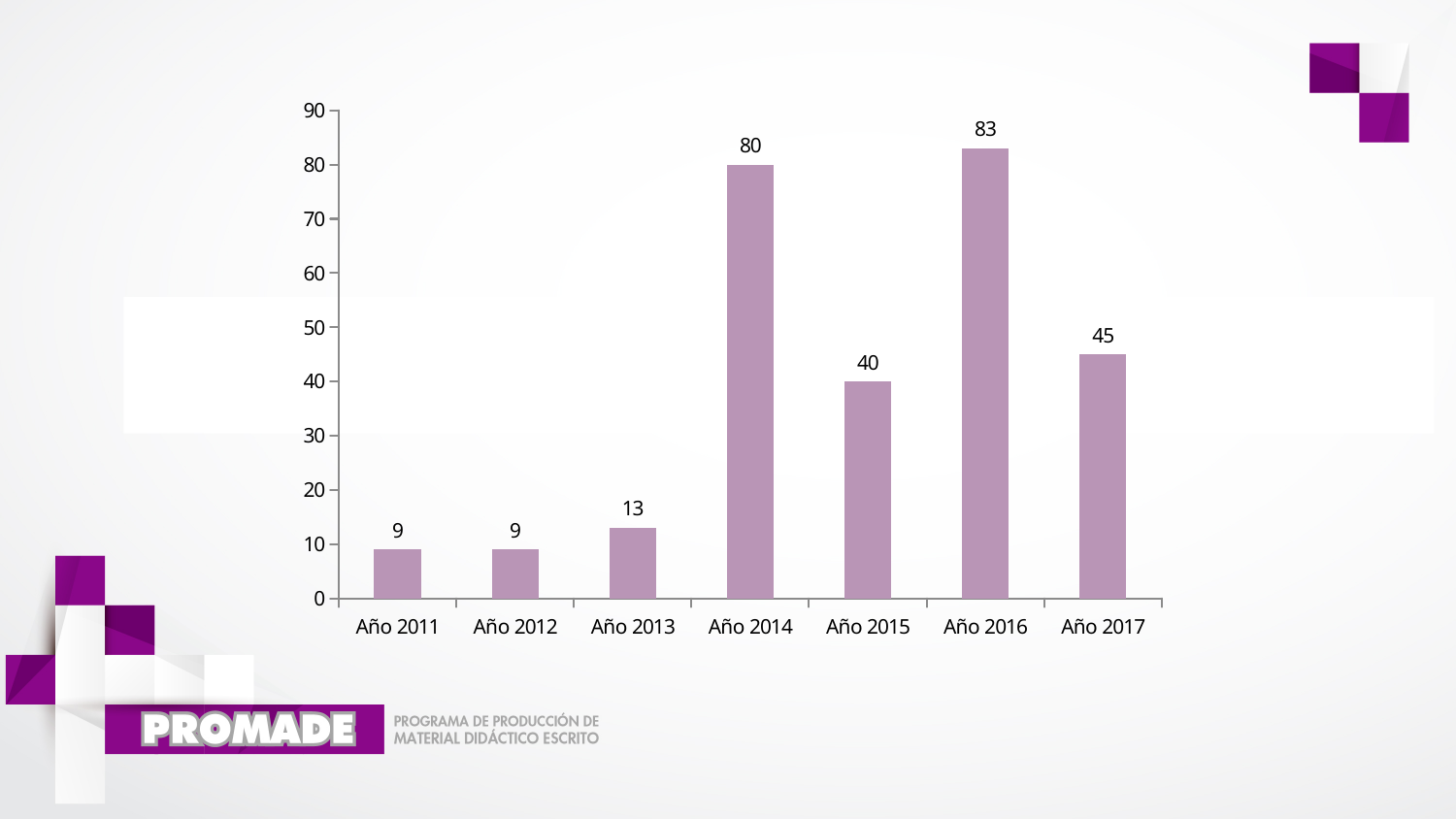
Which two years share the lowest value? Año 2011 and Año 2012 What kind of chart is shown on the slide? bar chart What is the value for Año 2014? 80 How many years are shown on the x axis? 7 Is the value for Año 2015 greater or less than 50? less What is the value for Año 2013? 13 What is the difference between the values for Año 2016 and Año 2015? 43 Which is larger, the value for Año 2014 or the value for Año 2017? Año 2014 What is the value for Año 2017? 45 What is the difference between the values for Año 2014 and Año 2013? 67 Which year has the highest value? Año 2016 What is the highest value shown on the y axis? 90